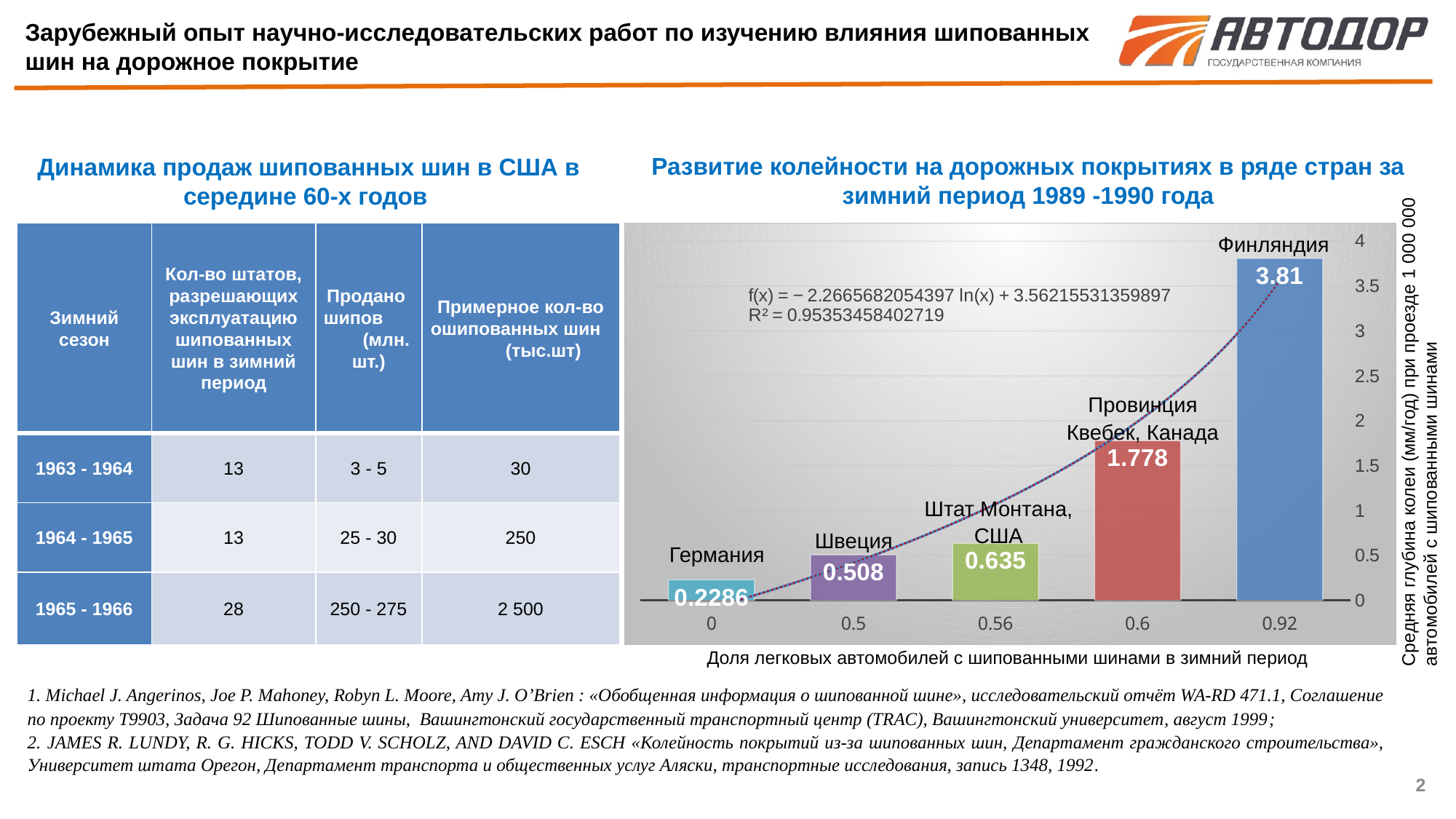
Which has a larger value, Швеция or Штат Монтана, США? Штат Монтана, США How many bars (countries or regions) are shown in the chart? 5 Which country or region has the lowest rut depth value? Германия What is the value shown for Провинция Квебек, Канада? 1.778 What is the rut depth value shown for Финляндия? 3.81 What is the R² value of the trendline shown on the chart? 0.95353458402719 What type of chart is shown on the slide? Bar chart What is the difference between the values for Финляндия and Провинция Квебек, Канада? 2.032 Which country or region has the highest rut depth value? Финляндия What is the value shown for Штат Монтана, США? 0.635 What is the value shown for Швеция? 0.508 What is the value shown for Германия? 0.2286